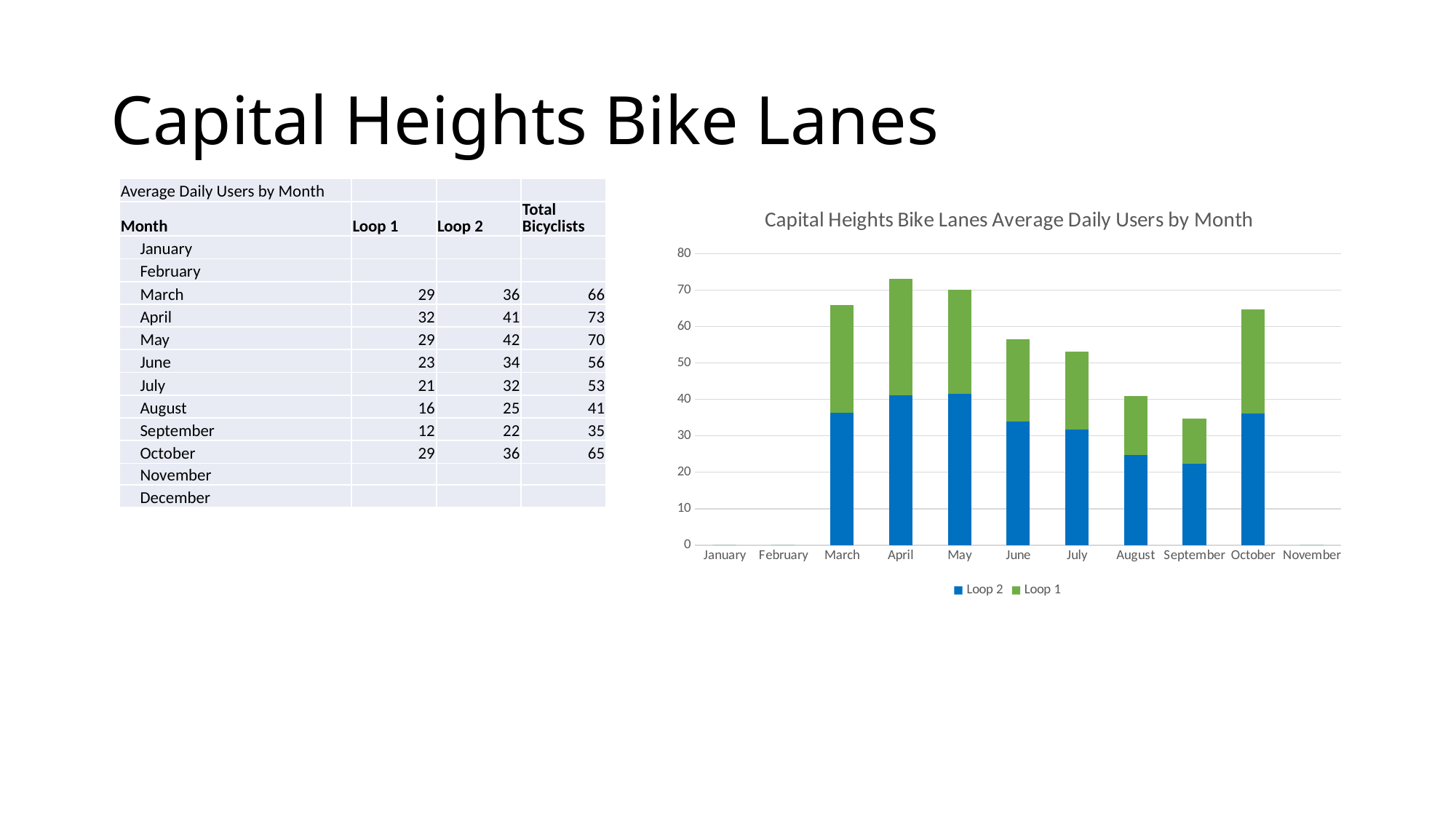
Is the total stacked bar for September greater or less than 40? less How much larger is the Loop 2 value for April than the Loop 2 value for March? 5 What are the two series named in the chart legend? Loop 2 and Loop 1 Among the months with a bar, which month has the shortest stacked bar? September What is the Loop 1 value for August? 16 What is the total of the stacked bar for April? 73 What is the Loop 2 value for May? 42 How many months on the chart's x axis have a bar plotted? 8 How many series does the chart legend list? 2 Which is larger, the Loop 2 value for April or the Loop 2 value for October? April Which month has the tallest stacked bar in the chart? April What kind of chart is shown on the slide? bar chart